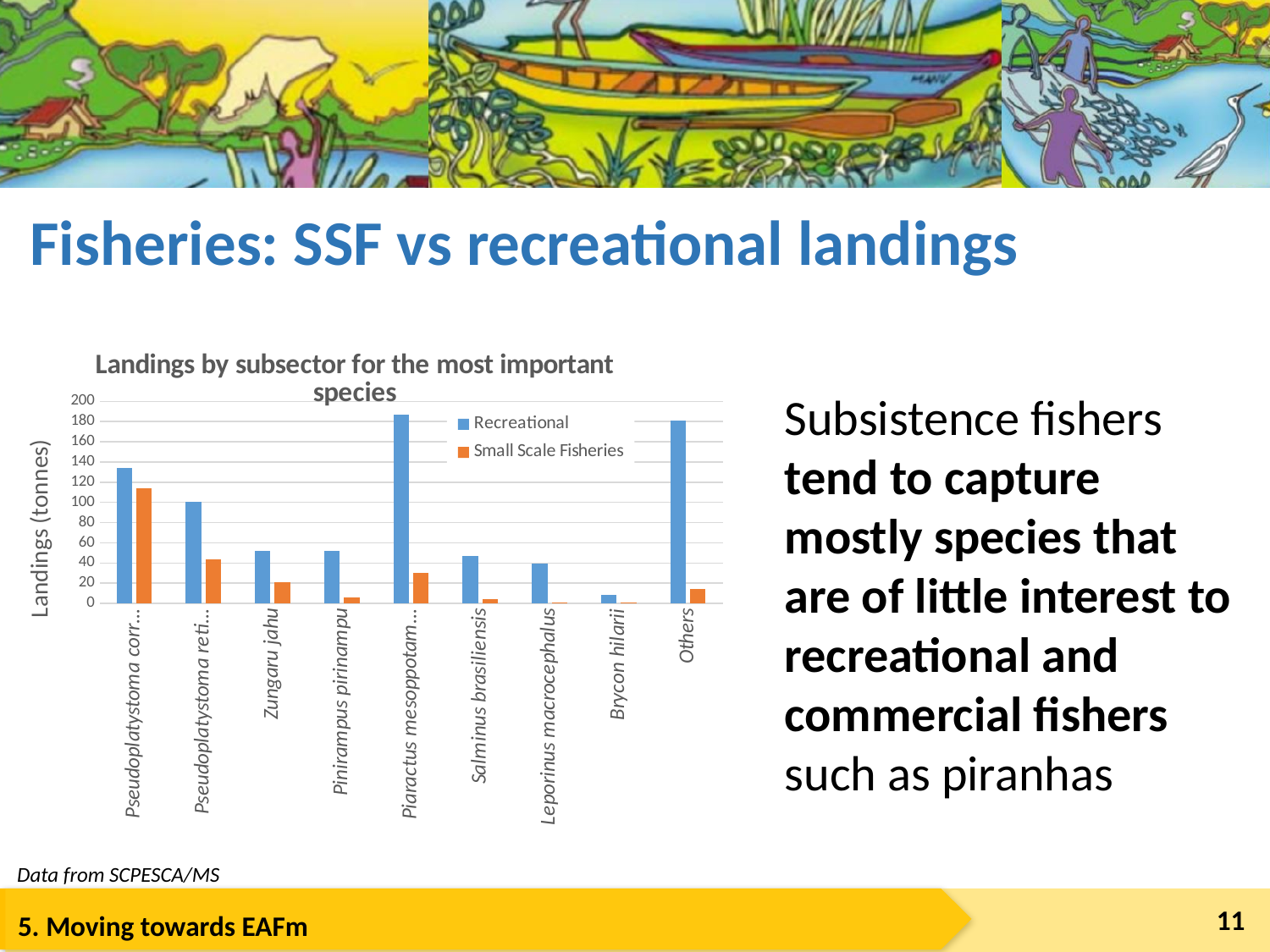
Is the Recreational value for Pseudoplatystoma corr... greater or less than 120? greater Is the Recreational value for Zungaru jahu greater or less than 60? less How many species categories are shown on the x axis of the chart? 9 How many series does the legend of the chart list? 2 Which is larger: the Small Scale Fisheries value for Piaractus mesoppotam... or for Zungaru jahu? Piaractus mesoppotam... Which category has the highest Small Scale Fisheries landings? Pseudoplatystoma corr... Is the Small Scale Fisheries value for Pseudoplatystoma corr... greater or less than 100? greater What is the title of the chart's vertical axis? Landings (tonnes) Which category has the lowest Recreational landings? Brycon hilarii For Pseudoplatystoma reti..., which is larger: the Recreational or the Small Scale Fisheries landings? Recreational What kind of chart is shown on the slide? bar chart